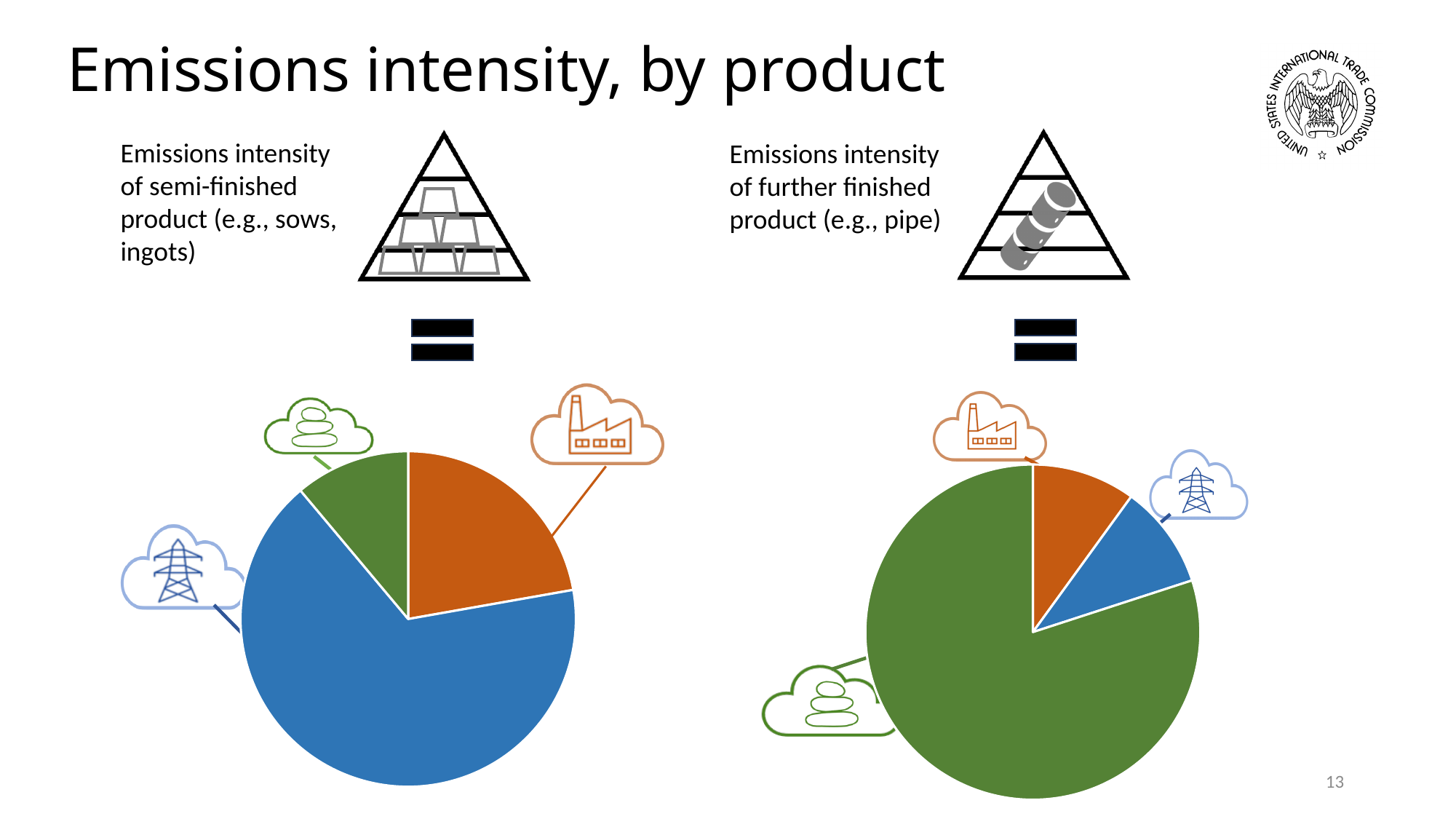
How many slices does the right pie chart have? 3 What kind of chart is the left chart on the slide? pie chart How many slices does the left pie chart have? 3 In the left pie chart, which colour slice is the smallest? green In the right pie chart, is the green slice or the orange slice larger? green What kind of chart is the right chart on the slide? pie chart In the left pie chart, is the blue slice or the orange slice larger? blue In the left pie chart, which colour slice is the largest? blue In the right pie chart, which colour slice is the largest? green What is the title of the slide containing the pie charts? Emissions intensity, by product How many pie charts are shown on the slide? 2